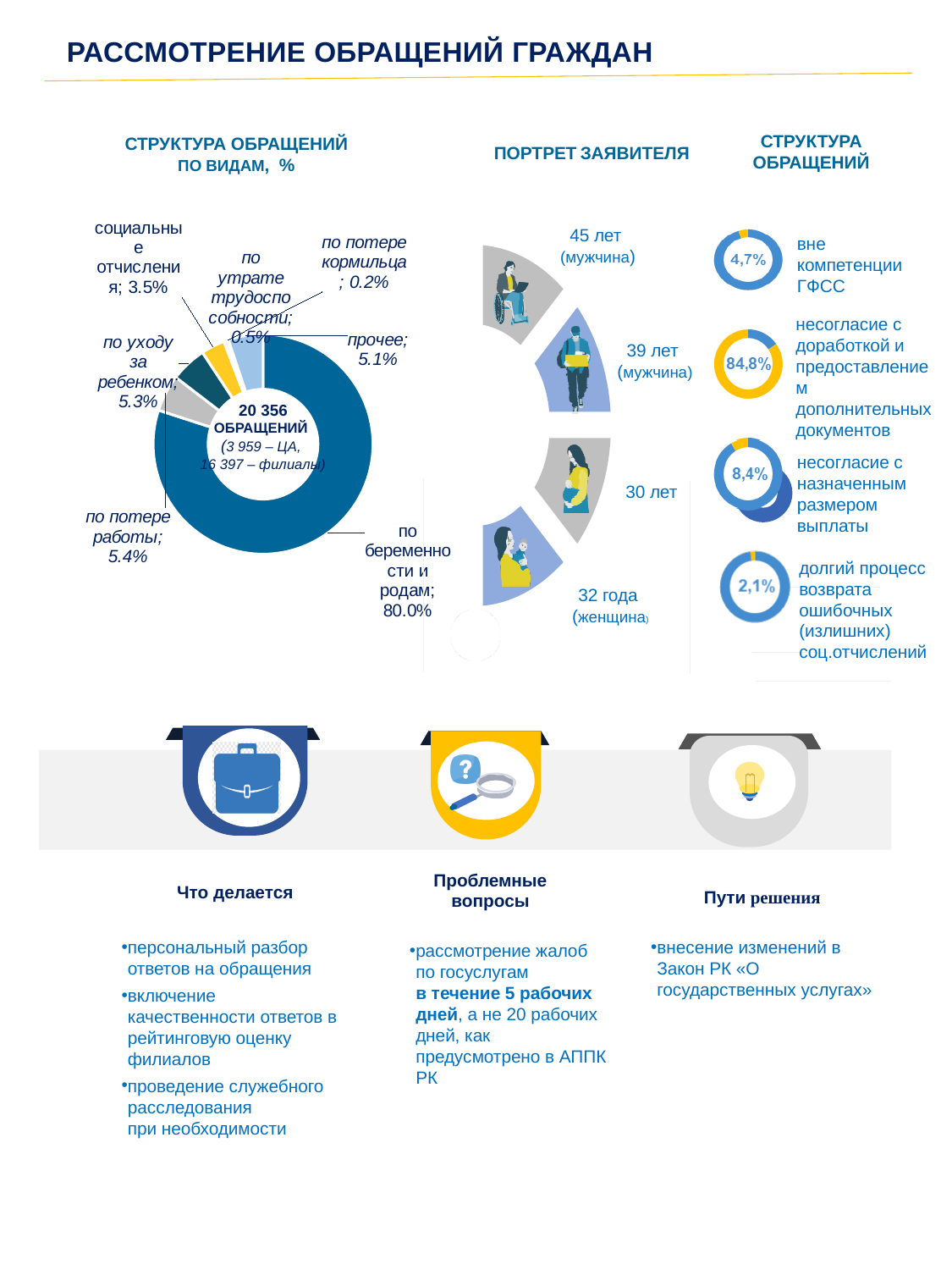
In the chart 'СТРУКТУРА ОБРАЩЕНИЙ ПО ВИДАМ, %', which is larger: 'прочее' or 'социальные отчисления'? прочее In the chart 'СТРУКТУРА ОБРАЩЕНИЙ ПО ВИДАМ, %', what is the share for 'по потере работы'? 5.4% In the chart 'СТРУКТУРА ОБРАЩЕНИЙ ПО ВИДАМ, %', which category has the largest share? по беременности и родам In the chart 'СТРУКТУРА ОБРАЩЕНИЙ ПО ВИДАМ, %', which category has the smallest share? по потере кормильца What kind of chart is 'СТРУКТУРА ОБРАЩЕНИЙ ПО ВИДАМ, %'? Donut (pie) chart In the 'СТРУКТУРА ОБРАЩЕНИЙ' charts on the right, what is the value for 'несогласие с назначенным размером выплаты'? 8,4% In the chart 'СТРУКТУРА ОБРАЩЕНИЙ ПО ВИДАМ, %', what total number of appeals is shown in the centre? 20 356 In the 'СТРУКТУРА ОБРАЩЕНИЙ' charts on the right, which category has the largest value? несогласие с доработкой и предоставлением дополнительных документов In the chart 'СТРУКТУРА ОБРАЩЕНИЙ ПО ВИДАМ, %', how many categories are shown? 7 In the chart 'СТРУКТУРА ОБРАЩЕНИЙ ПО ВИДАМ, %', what is the difference between the shares for 'по потере работы' and 'по уходу за ребенком'? 0.1% In the chart 'СТРУКТУРА ОБРАЩЕНИЙ ПО ВИДАМ, %', what is the share for 'по беременности и родам'? 80.0% In the chart 'СТРУКТУРА ОБРАЩЕНИЙ ПО ВИДАМ, %', what is the share for 'по потере кормильца'? 0.2%